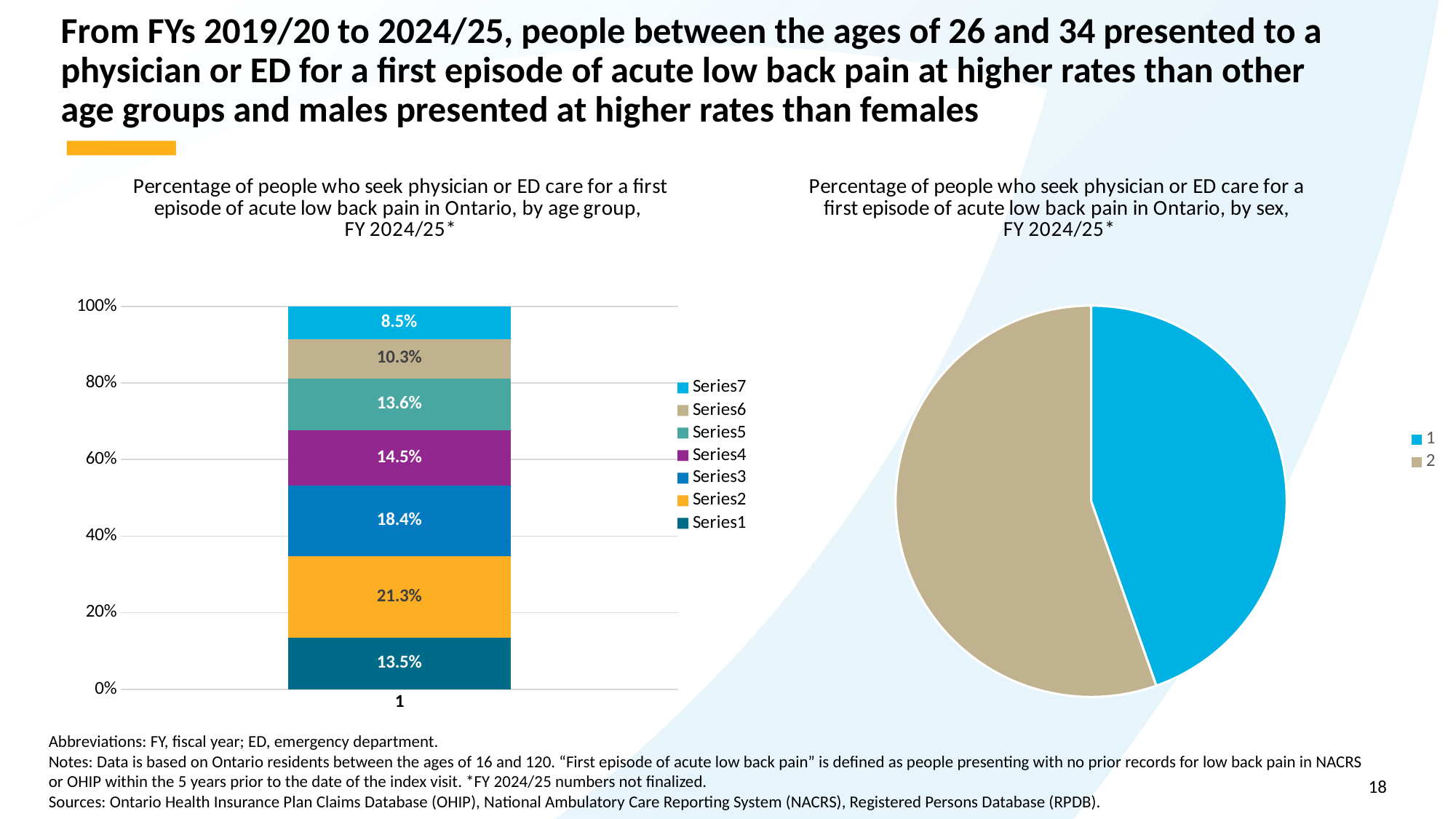
In the left chart (by age group), which series has the highest value? Series2 In the left chart (by age group), what is the difference between the values for Series5 and Series6? 3.3% In the left chart (by age group), which series has the lowest value? Series7 What kind of chart is the right chart, 'Percentage of people who seek physician or ED care for a first episode of acute low back pain in Ontario, by sex, FY 2024/25'? Pie chart In the left chart (by age group), what is the difference between the values for Series2 and Series1? 7.8% In the left chart (by age group), what is the value for Series7? 8.5% In the left chart (by age group), which is larger, Series3 or Series4? Series3 What kind of chart is the left chart, 'Percentage of people who seek physician or ED care for a first episode of acute low back pain in Ontario, by age group, FY 2024/25'? Stacked bar chart In the right chart (by sex), which slice is larger, 1 or 2? 2 In the left chart (by age group), what is the value for Series2? 21.3% How many entries does the legend of the right chart (by sex) list? 2 How many series does the legend of the left chart (by age group) list? 7